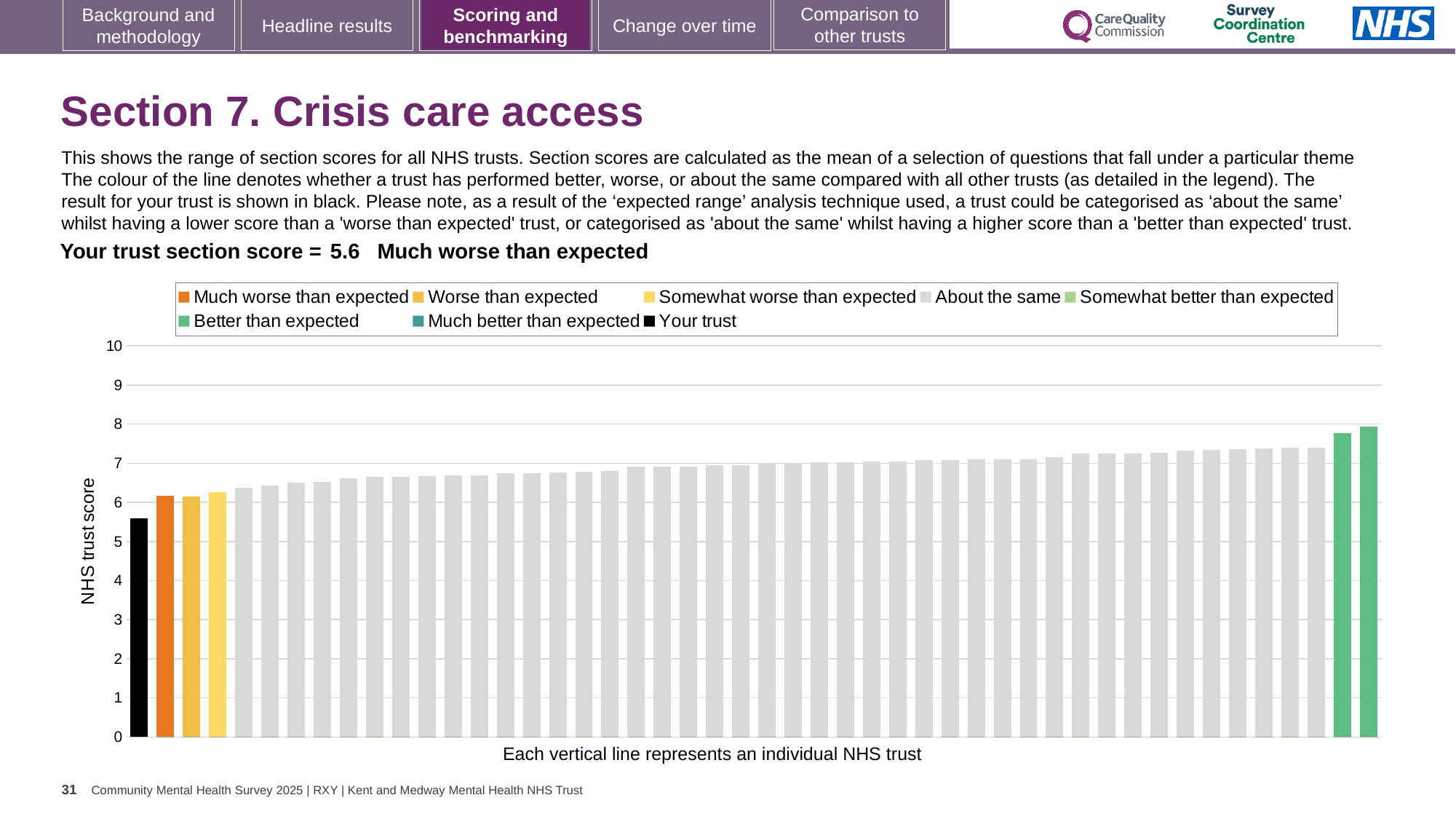
What is the section score for your trust shown on the slide? 5.6 What kind of chart is shown on the slide? bar chart Is the value of the black 'Your trust' bar greater or less than 6? less What is the label on the y axis of the chart? NHS trust score Is the value of the tallest bar greater or less than 7? greater How many green 'Better than expected' bars are shown at the right of the chart? 2 Which bar is the lowest in the chart? the black 'Your trust' bar What colour is the bar representing your trust? black How is your trust's section score categorised according to the slide? Much worse than expected How many entries does the chart legend list? 8 Do the bar values rise or fall from left to right along the x axis? rise